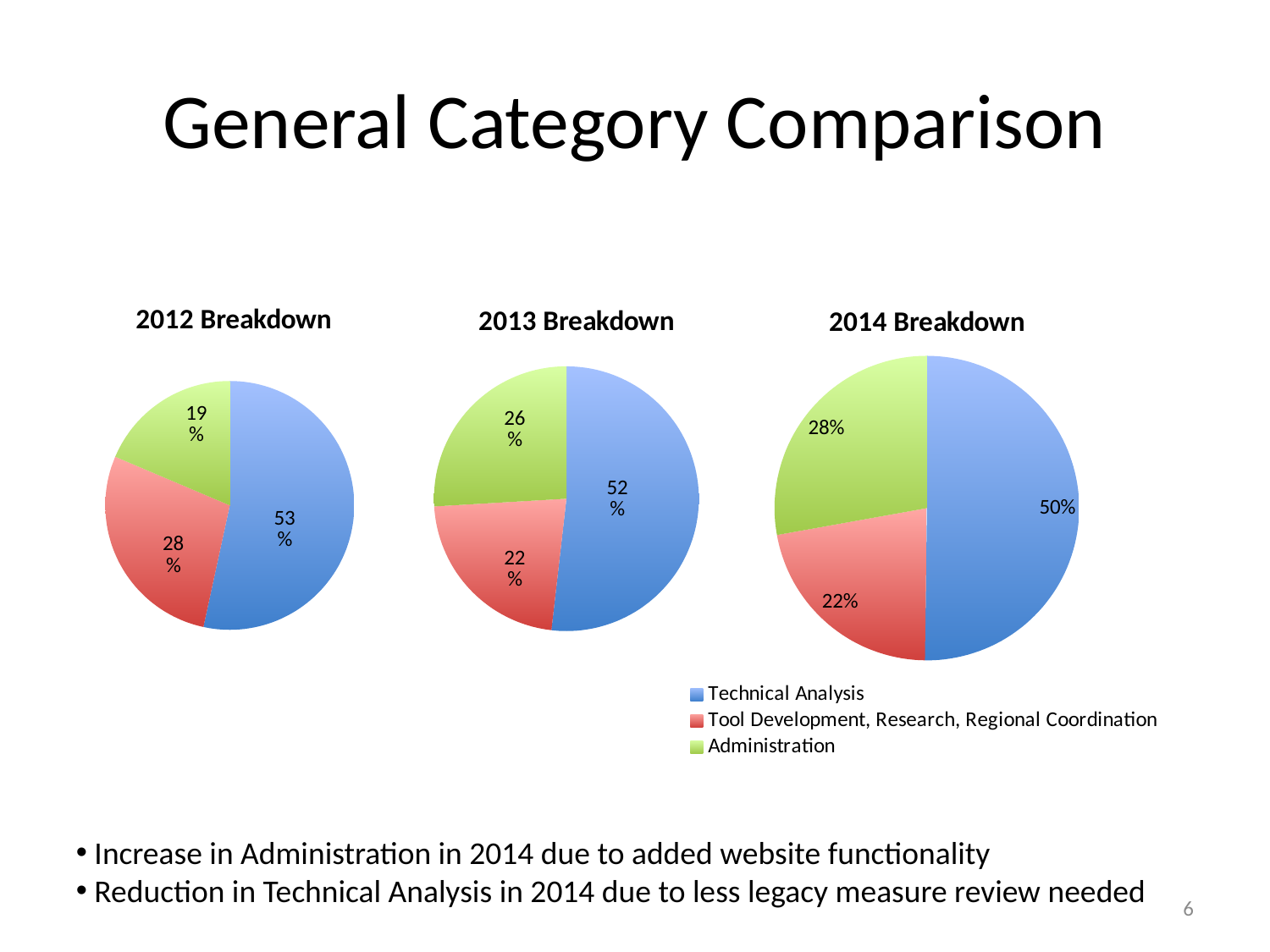
In the 2012 Breakdown chart, what share does Administration have? 19% What kind of chart is the 2014 Breakdown chart? Pie chart In the 2012 Breakdown chart, which category has the smallest slice? Administration In the 2013 Breakdown chart, which is larger: Administration or Tool Development, Research, Regional Coordination? Administration In the 2014 Breakdown chart, what share does Administration have? 28% How many slices does the 2013 Breakdown chart have? 3 In the 2013 Breakdown chart, what share does Tool Development, Research, Regional Coordination have? 22% In the 2014 Breakdown chart, what is the difference in percentage points between Technical Analysis and Administration? 22 How many entries does the legend list? 3 In the 2012 Breakdown chart, what is the difference in percentage points between Technical Analysis and Tool Development, Research, Regional Coordination? 25 In the 2014 Breakdown chart, which category has the largest slice? Technical Analysis In the 2012 Breakdown chart, what share does Technical Analysis have? 53%